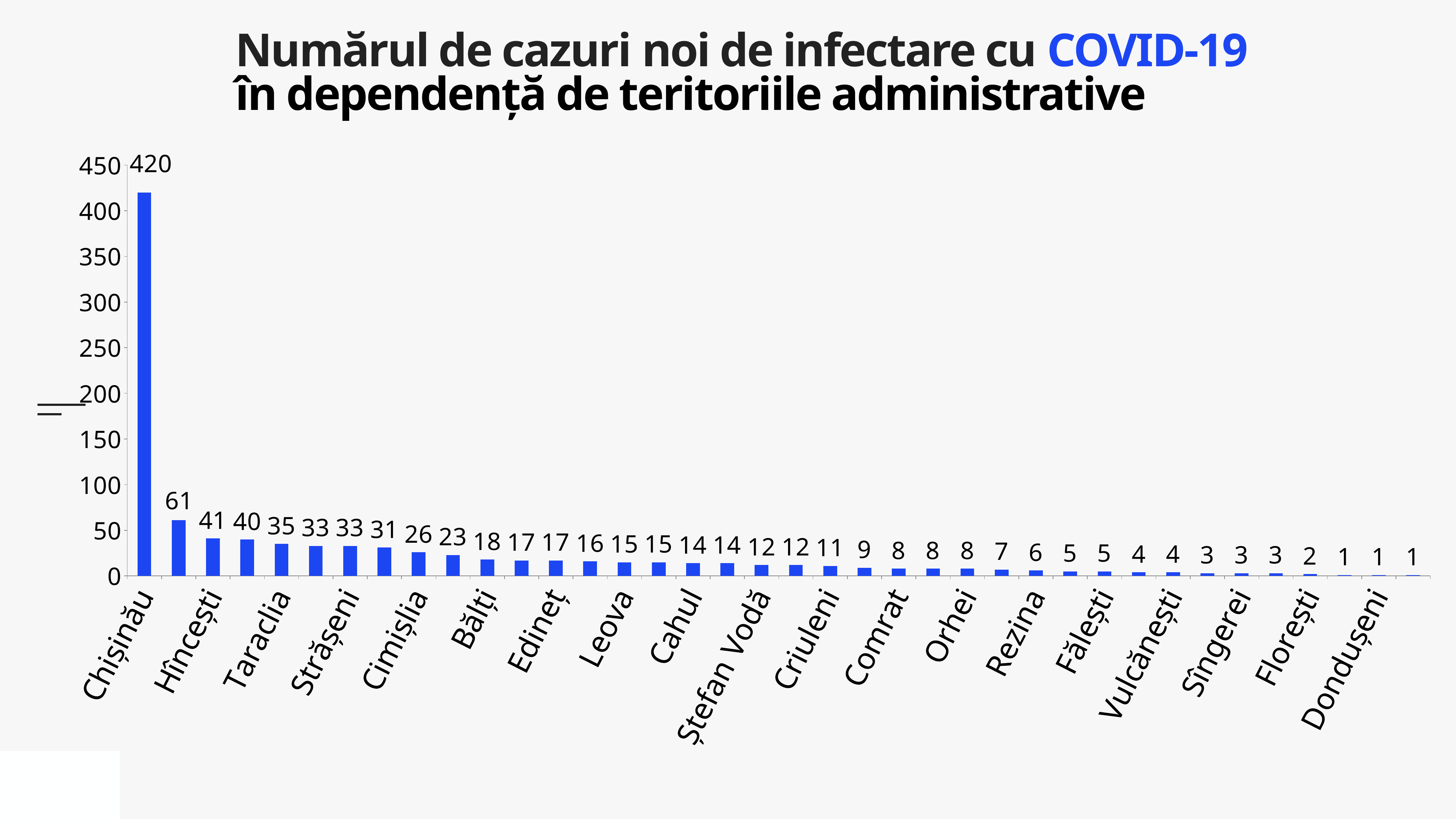
What is the value for Chișinău? 420 Which is larger, the value for Leova or the value for Comrat? Leova What is the value for Comrat? 8 Is the value for Chișinău greater or less than 400? greater What is the value for Sîngerei? 3 Do the values rise or fall from left to right along the x axis? fall What is the difference between the values for Chișinău and Leova? 405 What is the value for Ștefan Vodă? 12 What is the value for Dondușeni? 1 What kind of chart is shown on the slide? bar chart What is the value for Leova? 15 Which territory has the highest number of new cases? Chișinău